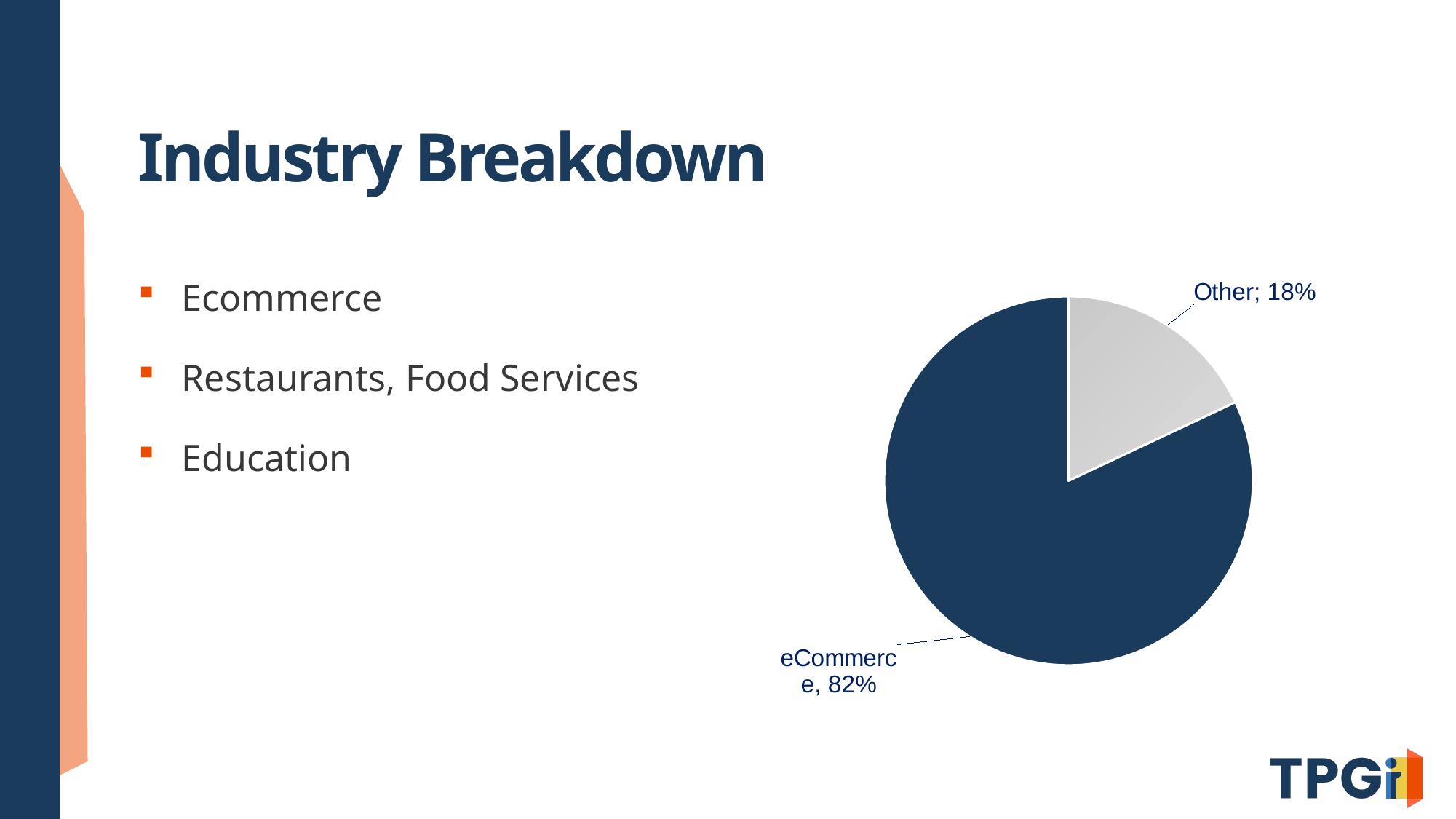
What is the combined share of the eCommerce and Other slices? 100% What colour is the eCommerce slice of the pie? dark blue What share of the pie does eCommerce represent? 82% What kind of chart is shown on the slide? pie chart Which slice of the pie is the smallest? Other Which slice of the pie is the largest? eCommerce How many slices does the pie chart have? 2 Which slice is larger, eCommerce or Other? eCommerce What share of the pie does Other represent? 18% What is the difference in percentage points between the eCommerce and Other slices? 64 What colour is the Other slice of the pie? light grey